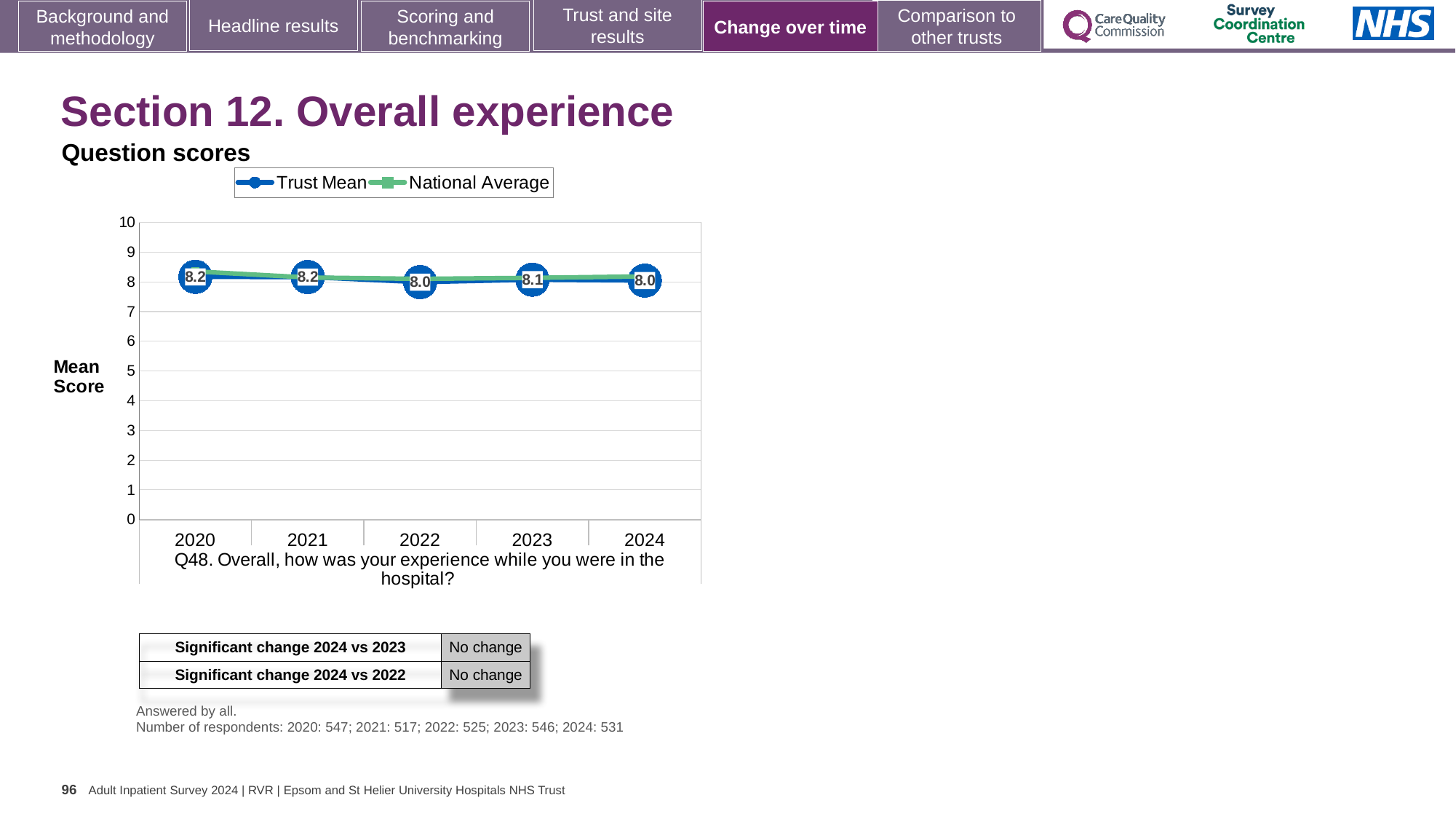
How many series does the legend list? 2 Does the Trust Mean score rise or fall from 2020 to 2024? fall How many years are plotted on the x axis? 5 What kind of chart is shown on the slide? line chart What is the label on the y axis of the chart? Mean Score What is the Trust Mean score for 2022? 8.0 What is the Trust Mean score for 2020? 8.2 Is the National Average value for 2020 greater or less than 5? greater Which year has the larger Trust Mean score, 2021 or 2024? 2021 What is the Trust Mean score for 2024? 8.0 What is the difference between the Trust Mean scores for 2020 and 2022? 0.2 What is the Trust Mean score for 2023? 8.1